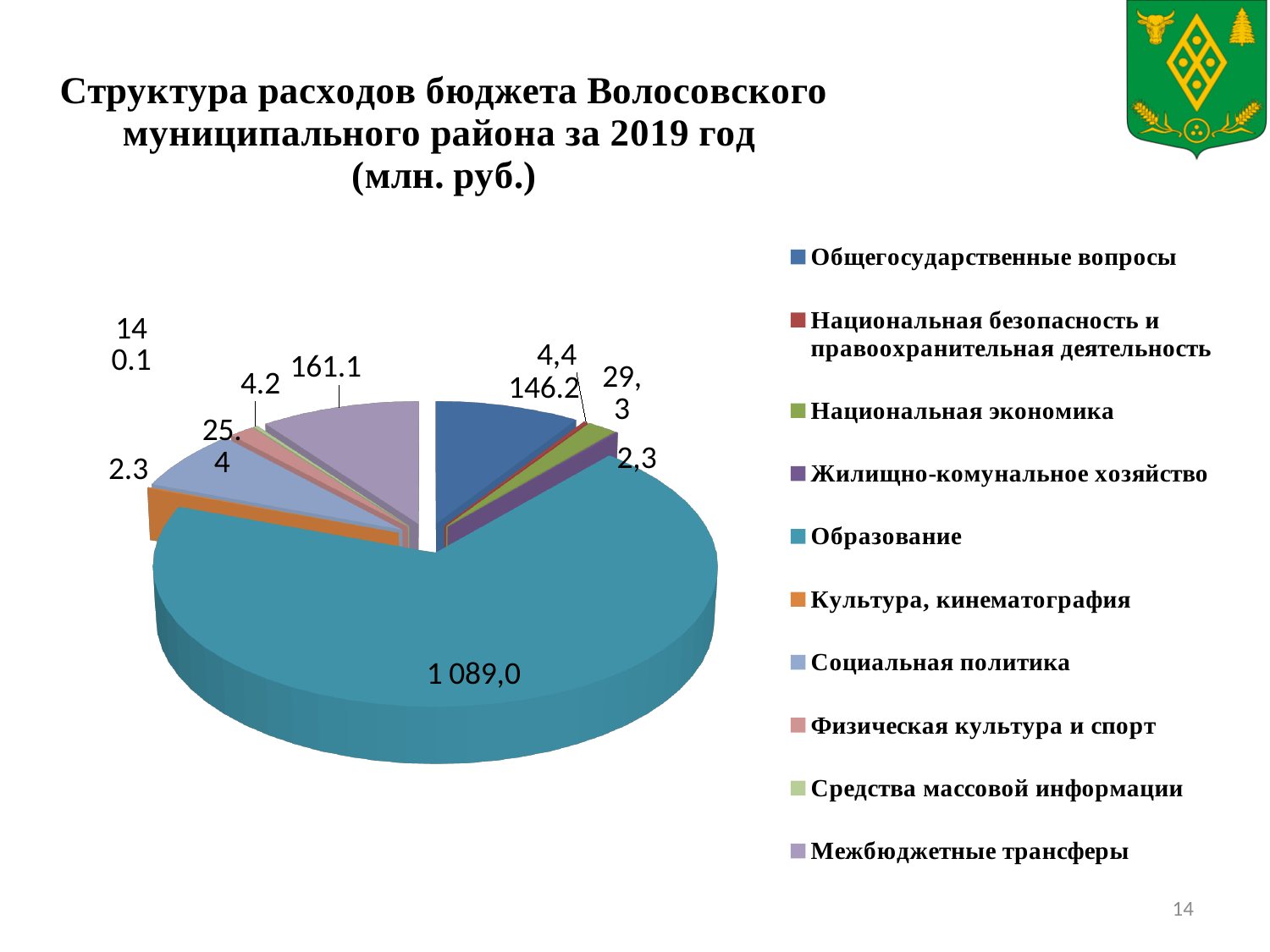
What kind of chart is shown on the slide? Pie chart What is the value for Межбюджетные трансферы? 161.1 Which category has the largest share of the pie? Образование What is the value for Общегосударственные вопросы? 146.2 What is the value for Образование? 1 089,0 What is the difference between the values for Межбюджетные трансферы and Общегосударственные вопросы? 14.9 Which is larger: Межбюджетные трансферы or Общегосударственные вопросы? Межбюджетные трансферы What is the title of the chart on the slide? Структура расходов бюджета Волосовского муниципального района за 2019 год (млн. руб.) What is the value for Национальная экономика? 29,3 How many categories does the legend of the pie chart list? 10